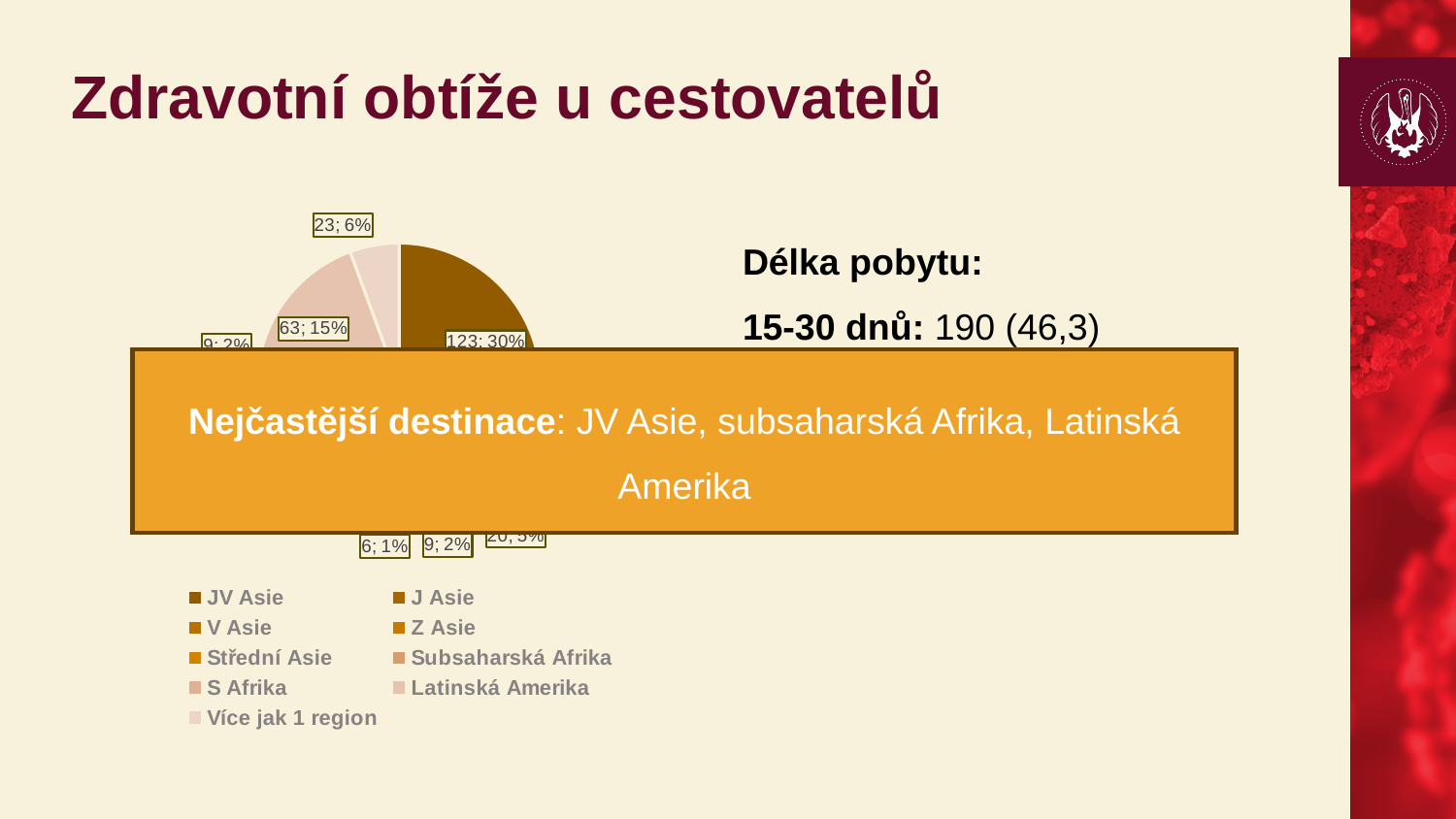
What kind of chart is shown on the slide? pie chart What is the first entry listed in the pie chart's legend? JV Asie What is the smallest value printed on any slice of the pie chart? 6; 1% What value is printed on the dark brown slice for JV Asie? 123; 30% What is the difference between the slice labelled 123 and the slice labelled 63? 60 What share of the pie does the JV Asie slice represent? 30% What is the last entry listed in the pie chart's legend? Více jak 1 region Which is larger, the slice labelled 63; 15% or the slice labelled 23; 6%? 63; 15% How many categories does the legend of the pie chart list? 9